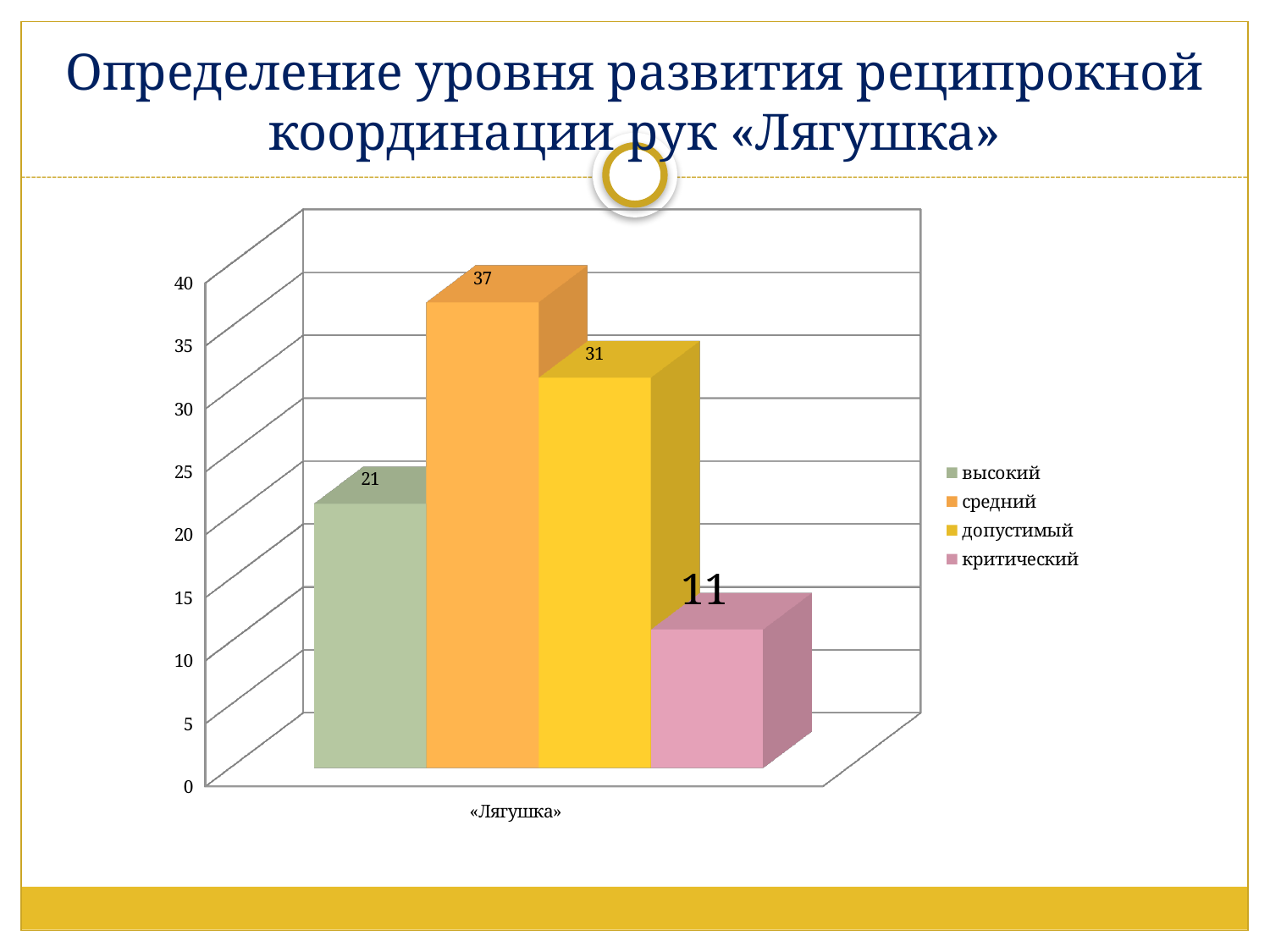
What is the difference between the values for «высокий» and «критический»? 10 Which is larger, the value for «высокий» or the value for «допустимый»? допустимый What kind of chart is shown on the slide? bar chart What is the category label shown on the x axis? «Лягушка» Which series has the highest value? средний What is the value for the «высокий» series? 21 What is the value for the «допустимый» series? 31 What is the difference between the values for «средний» and «допустимый»? 6 How many series does the legend list? 4 What is the value for the «средний» series? 37 Which series has the lowest value? критический What is the value for the «критический» series? 11